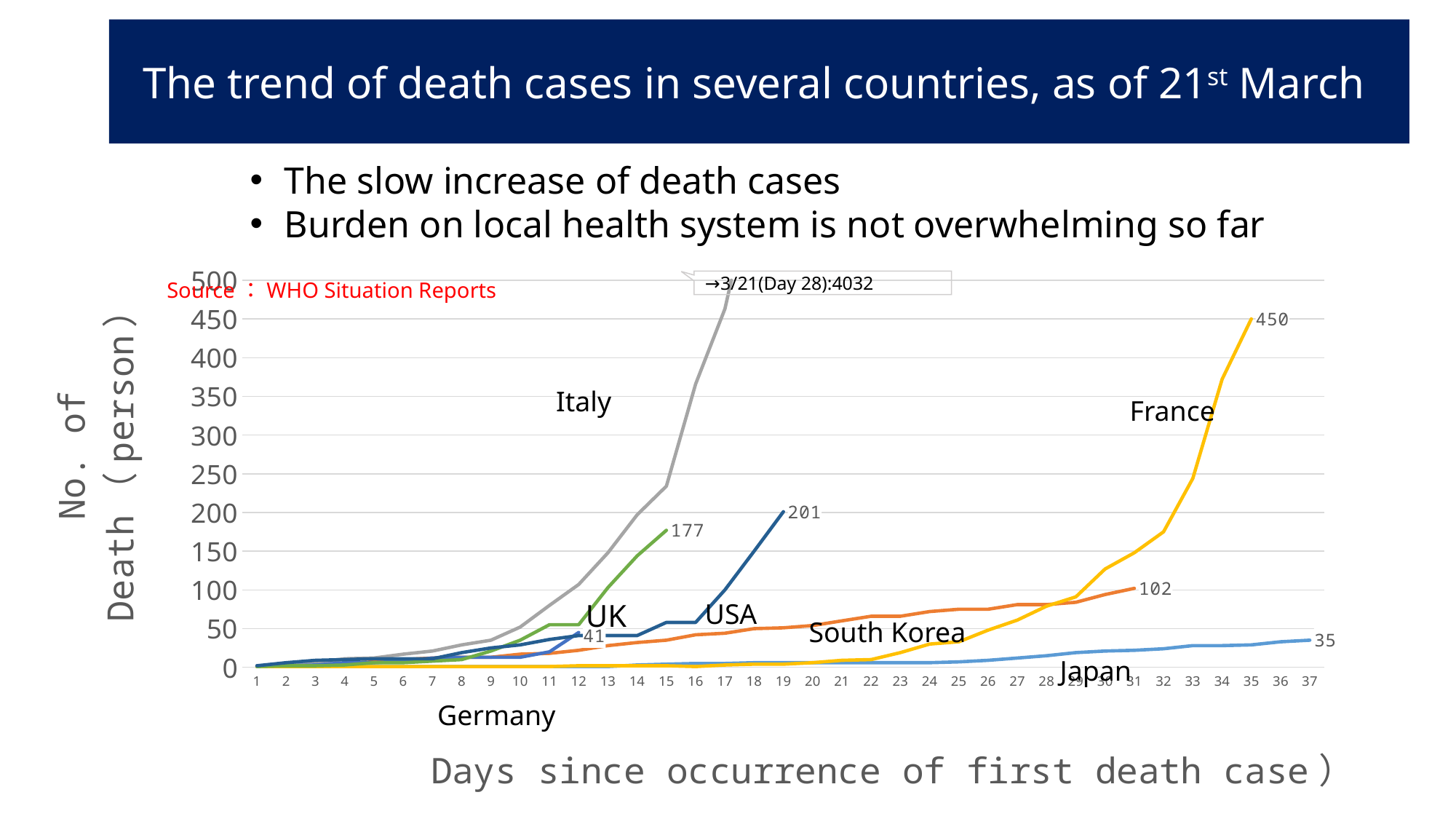
What is the difference between the final labelled values for the USA (201) and the UK (177)? 24 What source is cited for the chart data? WHO Situation Reports What kind of chart is shown on the slide? line chart How many countries are plotted on the chart? 7 According to the annotation, how many deaths did Italy have on Day 28 (3/21)? 4032 What is the final labelled number of deaths for the UK? 177 What is the final labelled number of deaths for the USA? 201 Which has the larger final labelled value, Germany or Japan? Germany Does the line for Japan rise or fall as the days increase? rise What is the final labelled number of deaths for South Korea? 102 What is the final labelled number of deaths for Japan? 35 What is the final labelled number of deaths for France? 450